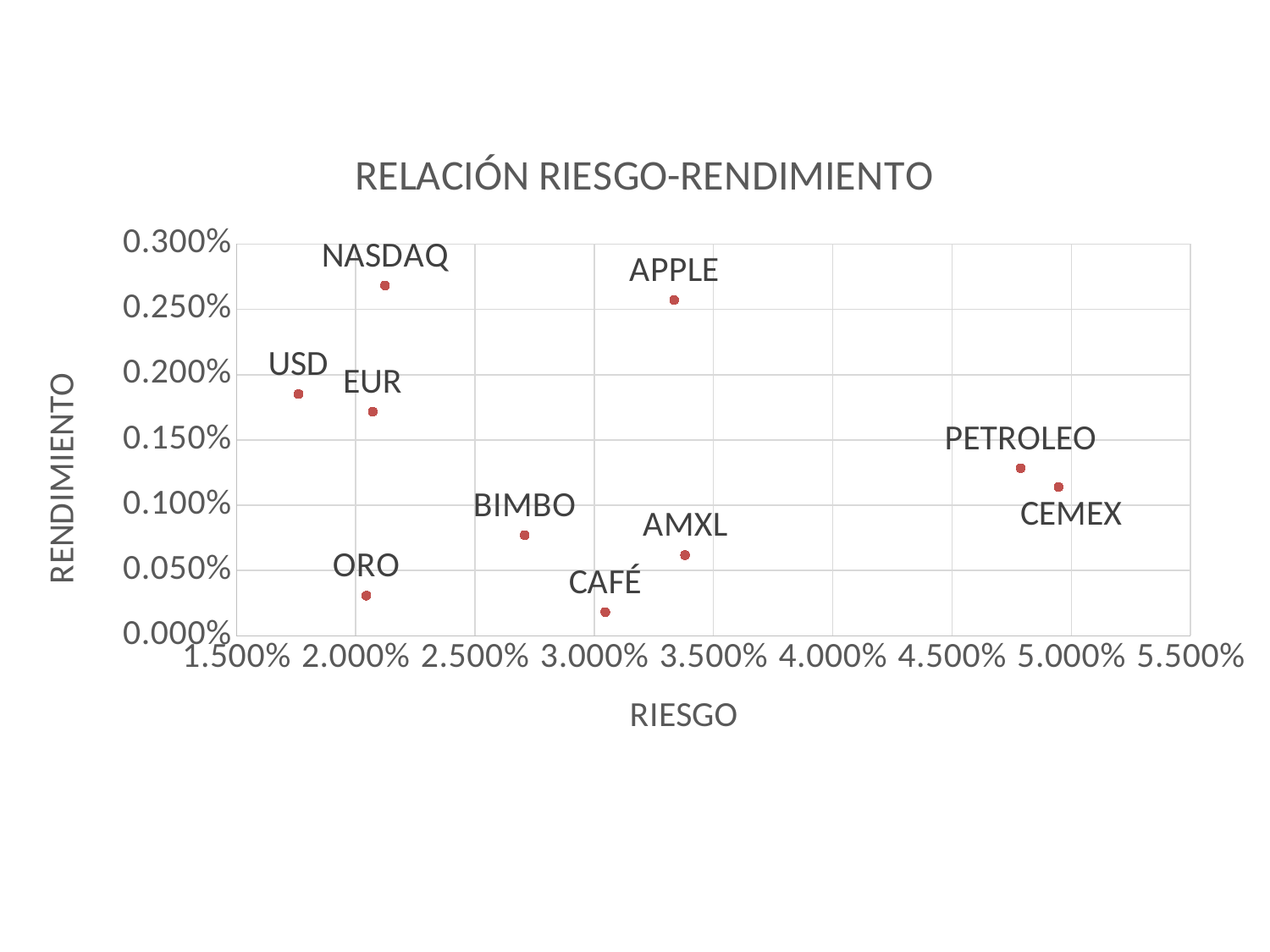
What kind of chart is shown on the slide? scatter chart Which point has the lowest RENDIMIENTO value? CAFÉ Which point has the highest RIESGO value? CEMEX Is the RENDIMIENTO value for CAFÉ greater or less than 0.050%? less What is the title of the chart? RELACIÓN RIESGO-RENDIMIENTO How many labeled data points are plotted on the chart? 10 What is the label of the vertical axis? RENDIMIENTO Which point has the lowest RIESGO value? USD Which has the higher RENDIMIENTO value, PETROLEO or CEMEX? PETROLEO Is the RIESGO value for CEMEX greater or less than 4.500%? greater Is the RENDIMIENTO value for NASDAQ greater or less than 0.250%? greater Which has the higher RENDIMIENTO value, USD or EUR? USD